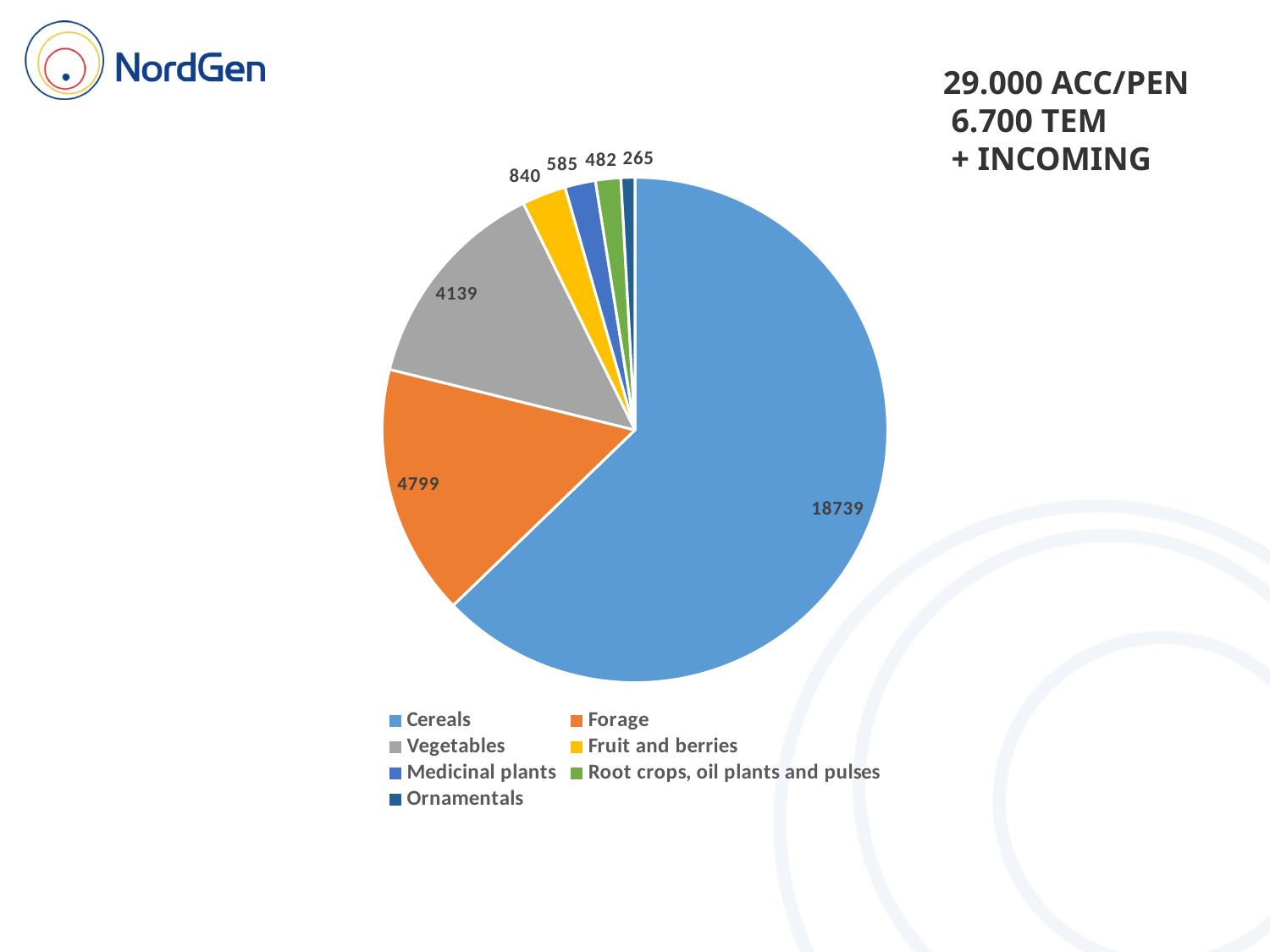
Which category has the smallest slice in the pie chart? Ornamentals Which is larger, Medicinal plants or Root crops, oil plants and pulses? Medicinal plants What is the value for Forage in the pie chart? 4799 How many categories does the pie chart show? 7 What kind of chart is shown on the slide? Pie chart Which category has the largest slice in the pie chart? Cereals What is the value for Ornamentals in the pie chart? 265 What is the difference between the values for Forage and Vegetables? 660 What is the value for Vegetables in the pie chart? 4139 What is the value for Fruit and berries in the pie chart? 840 What colour is the Fruit and berries slice in the pie chart? Yellow What is the value for Cereals in the pie chart? 18739